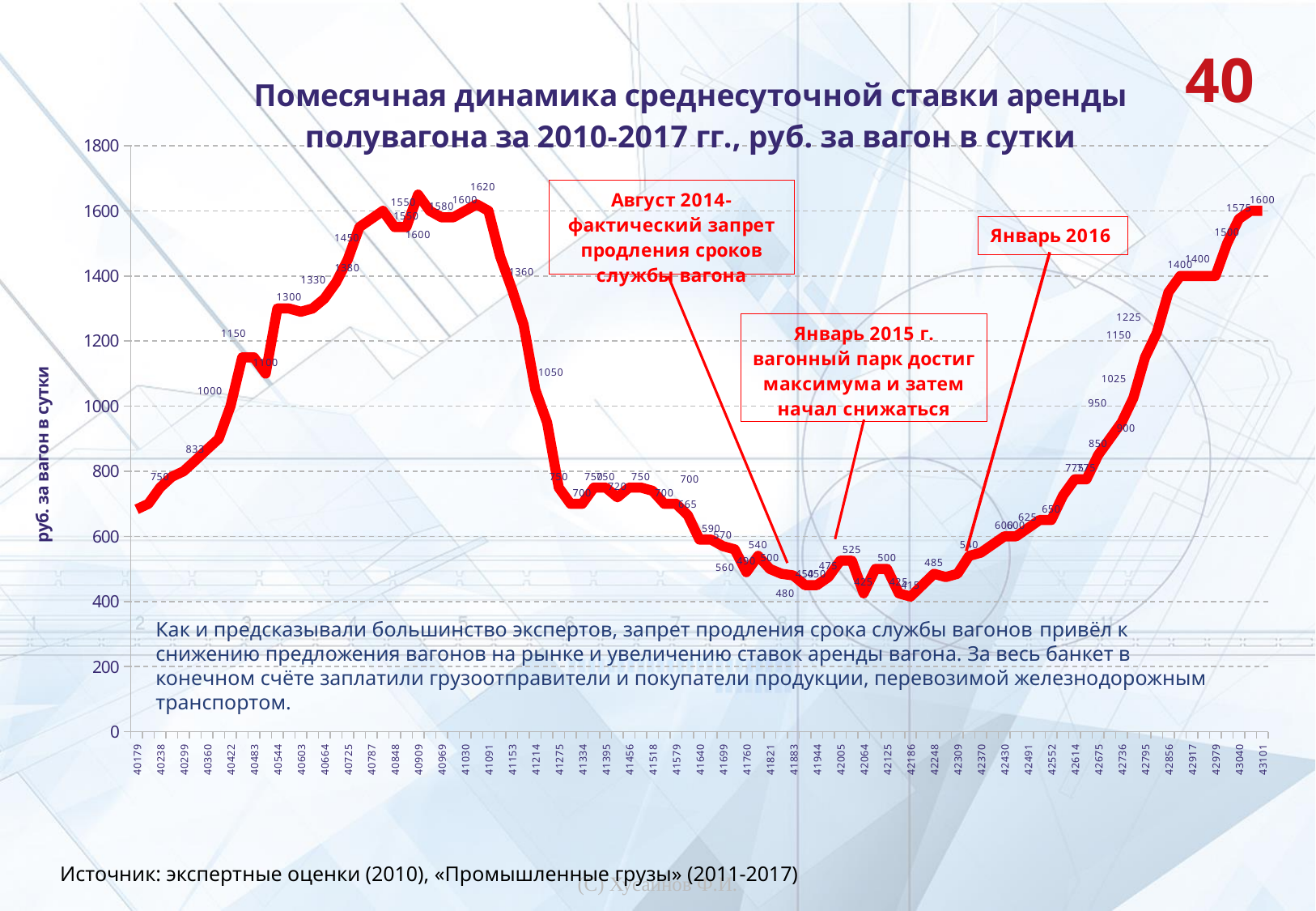
Is the value at the first point of the line (x-axis label 40179) greater or less than 800? less According to the annotation on the chart, what happened in August 2014? фактический запрет продления сроков службы вагона What is the highest value labelled on the line? 1620 What is the lowest value labelled on the line? 415 What is the label on the vertical axis? руб. за вагон в сутки What kind of chart is shown on the slide? line chart What is the difference between the highest labelled value (1620) and the lowest labelled value (415)? 1205 Does the line rise or fall between the x-axis labels 41091 and 41883? fall Does the line rise or fall between the x-axis labels 42186 and 43101? rise Which is larger: the peak value labelled 1620 or the final value labelled 1600? 1620 What is the value labelled at the last point of the line (x-axis label 43101)? 1600